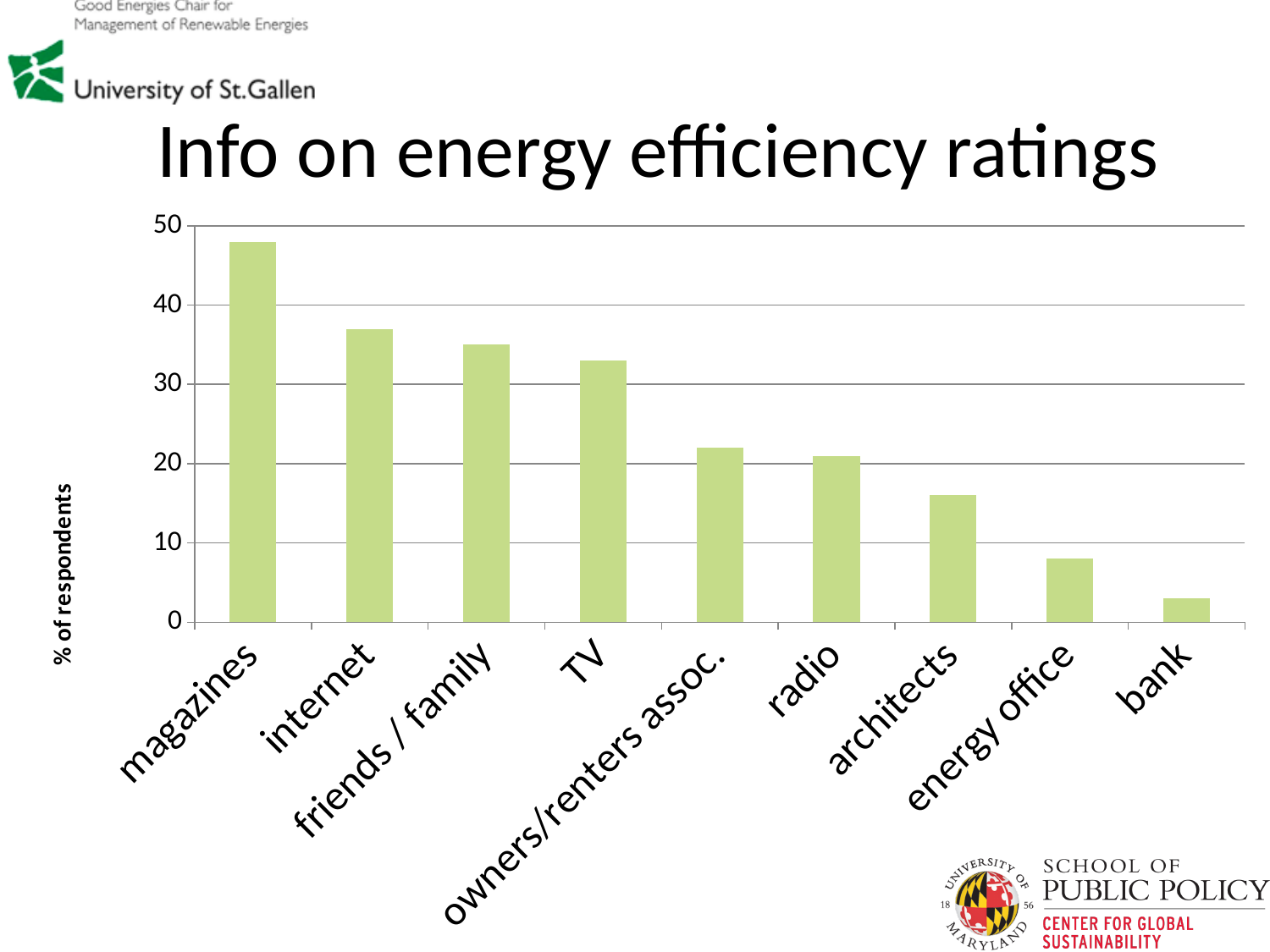
Is the value for energy office greater or less than 10? less Is the value for internet greater or less than 40? less Which category has the lowest value? bank Which is larger, the value for TV or the value for radio? TV Is the value for magazines greater or less than 40? greater What kind of chart is shown on the slide? bar chart Which category has the highest value? magazines How many categories are shown on the x axis? 9 Do the values rise or fall from left to right along the x axis? fall Which is larger, the value for magazines or the value for internet? magazines